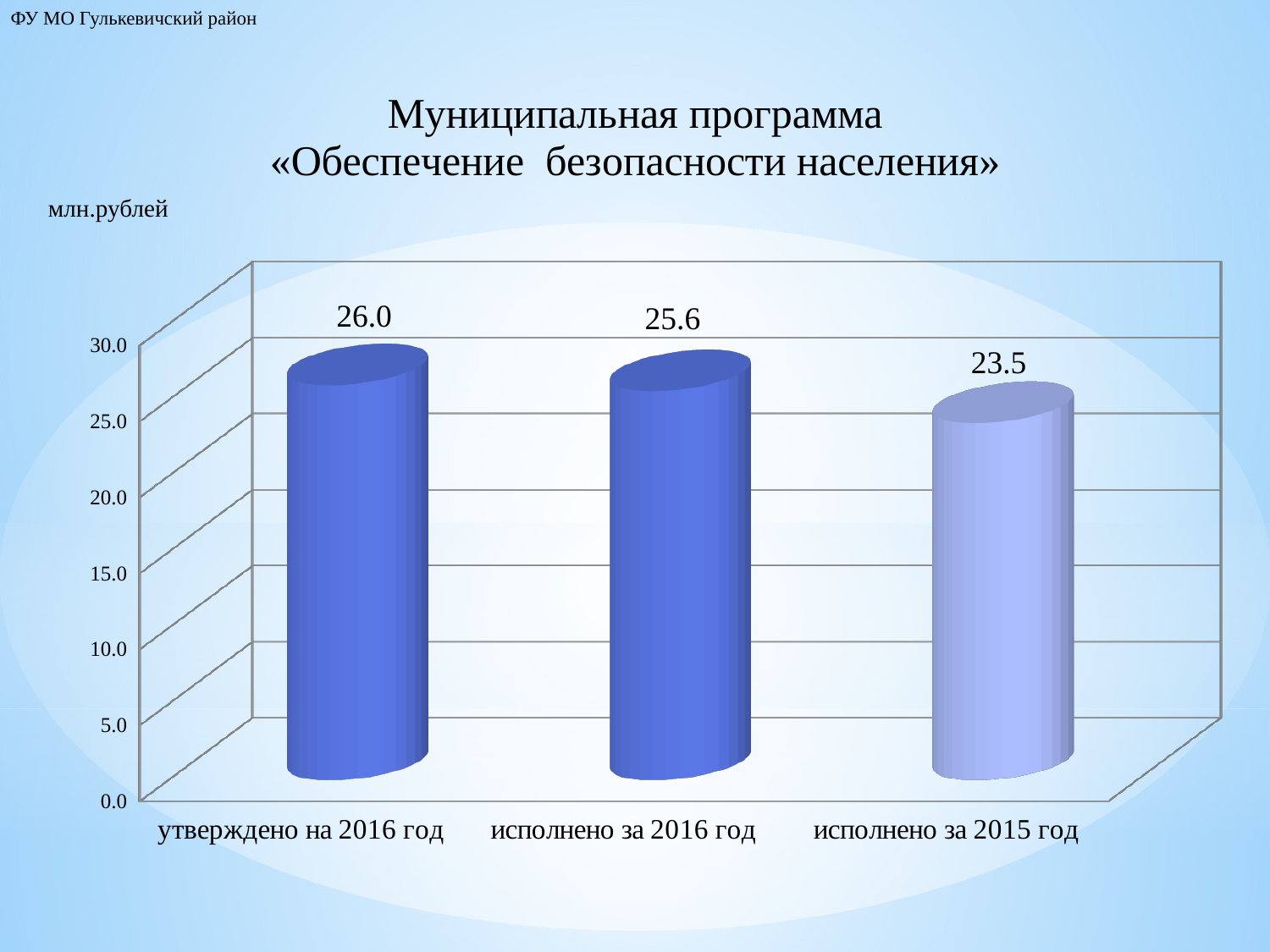
What kind of chart is shown on the slide? bar chart What is the difference between «утверждено на 2016 год» and «исполнено за 2016 год»? 0.4 How many categories are shown in the chart? 3 What is the value for «исполнено за 2015 год»? 23.5 Which category has the highest value? утверждено на 2016 год Which category has the lowest value? исполнено за 2015 год What unit of measurement is indicated for the chart values? млн.рублей What is the value for «утверждено на 2016 год»? 26.0 Is the value for «исполнено за 2015 год» greater or less than 25.0? less What is the difference between «исполнено за 2016 год» and «исполнено за 2015 год»? 2.1 What is the value for «исполнено за 2016 год»? 25.6 Which is larger: «исполнено за 2016 год» or «исполнено за 2015 год»? исполнено за 2016 год